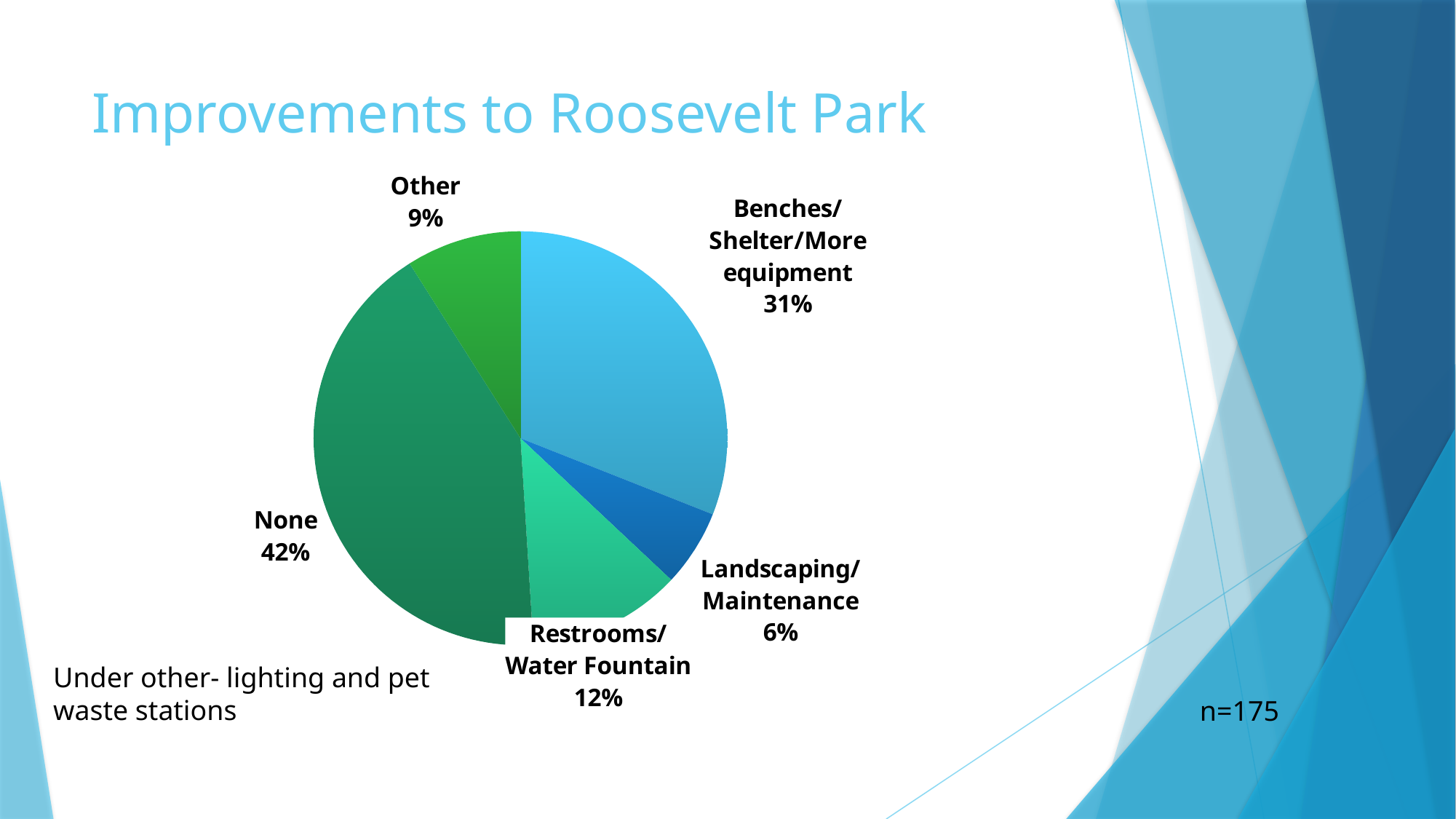
How many categories are shown in the pie chart? 5 What share of the pie does None account for? 42% What percentage is shown for Other? 9% What percentage is shown for Restrooms/Water Fountain? 12% What is the difference in percentage points between None and Benches/Shelter/More equipment? 11 Which category has the largest slice of the pie? None Which is larger, Restrooms/Water Fountain or Other? Restrooms/Water Fountain What percentage is shown for Landscaping/Maintenance? 6% Which category has the smallest slice of the pie? Landscaping/Maintenance What kind of chart is shown on the slide? Pie chart What percentage is shown for Benches/Shelter/More equipment? 31% What is the title of the slide? Improvements to Roosevelt Park